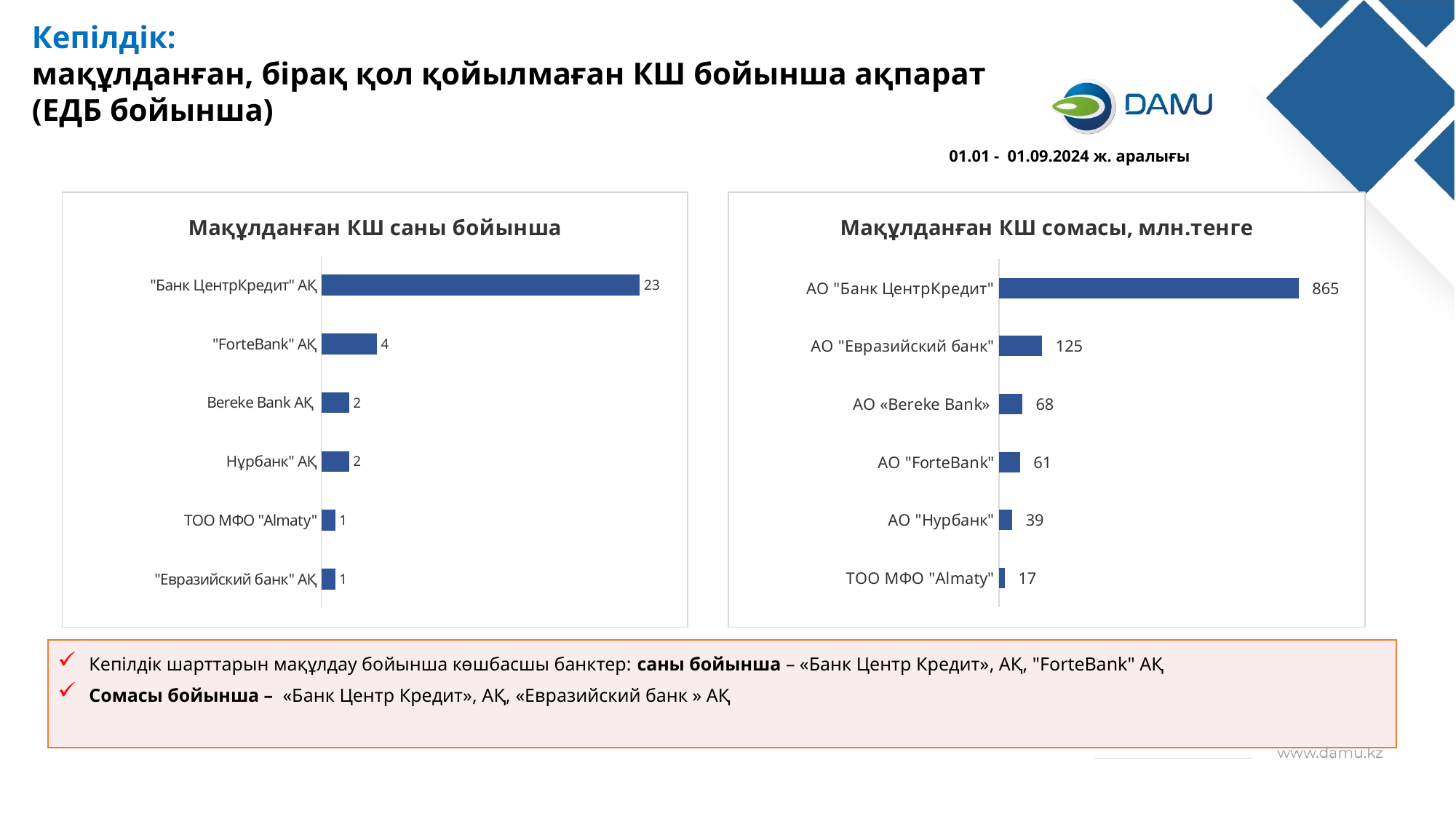
In the left chart 'Мақұлданған КШ саны бойынша', what is the value for ТОО МФО "Almaty"? 1 In the left chart 'Мақұлданған КШ саны бойынша', how many categories are shown? 6 In the left chart 'Мақұлданған КШ саны бойынша', what is the value for "ForteBank" АҚ? 4 In the left chart 'Мақұлданған КШ саны бойынша', what is the difference between "Банк ЦентрКредит" АҚ and "ForteBank" АҚ? 19 In the right chart 'Мақұлданған КШ сомасы, млн.тенге', what is the difference between АО "Банк ЦентрКредит" and АО "Евразийский банк"? 740 In the right chart 'Мақұлданған КШ сомасы, млн.тенге', which is larger: АО «Bereke Bank» or АО "ForteBank"? АО «Bereke Bank» In the right chart 'Мақұлданған КШ сомасы, млн.тенге', what is the value for АО "Нурбанк"? 39 In the left chart 'Мақұлданған КШ саны бойынша', which category has the highest value? "Банк ЦентрКредит" АҚ In the right chart 'Мақұлданған КШ сомасы, млн.тенге', what is the value for АО "Евразийский банк"? 125 What type of chart is the right chart 'Мақұлданған КШ сомасы, млн.тенге'? Bar chart In the right chart 'Мақұлданған КШ сомасы, млн.тенге', which category has the lowest value? ТОО МФО "Almaty" What is the title of the left chart? Мақұлданған КШ саны бойынша